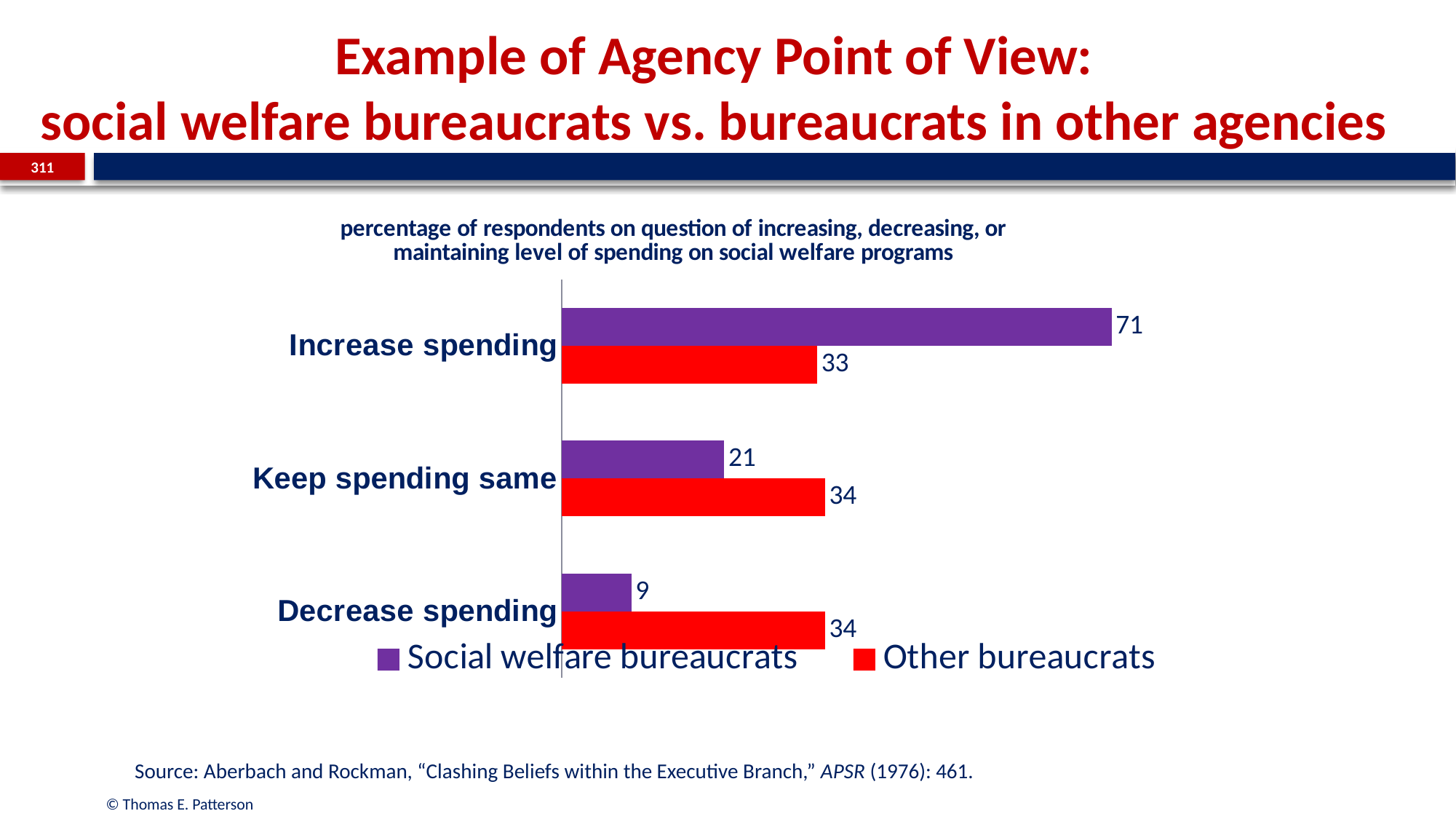
How many series does the legend list? 2 How many categories are shown on the chart? 3 What is the difference between social welfare bureaucrats and other bureaucrats for Increase spending? 38 What percentage of social welfare bureaucrats favor decreasing spending? 9 What percentage of other bureaucrats favor keeping spending the same? 34 For Keep spending same, which group has the larger value: social welfare bureaucrats or other bureaucrats? Other bureaucrats Which category has the lowest value for other bureaucrats? Increase spending Which category has the highest value for social welfare bureaucrats? Increase spending What percentage of other bureaucrats favor increasing spending? 33 Which category has the lowest value for social welfare bureaucrats? Decrease spending What percentage of social welfare bureaucrats favor increasing spending? 71 What kind of chart is shown on the slide? Bar chart